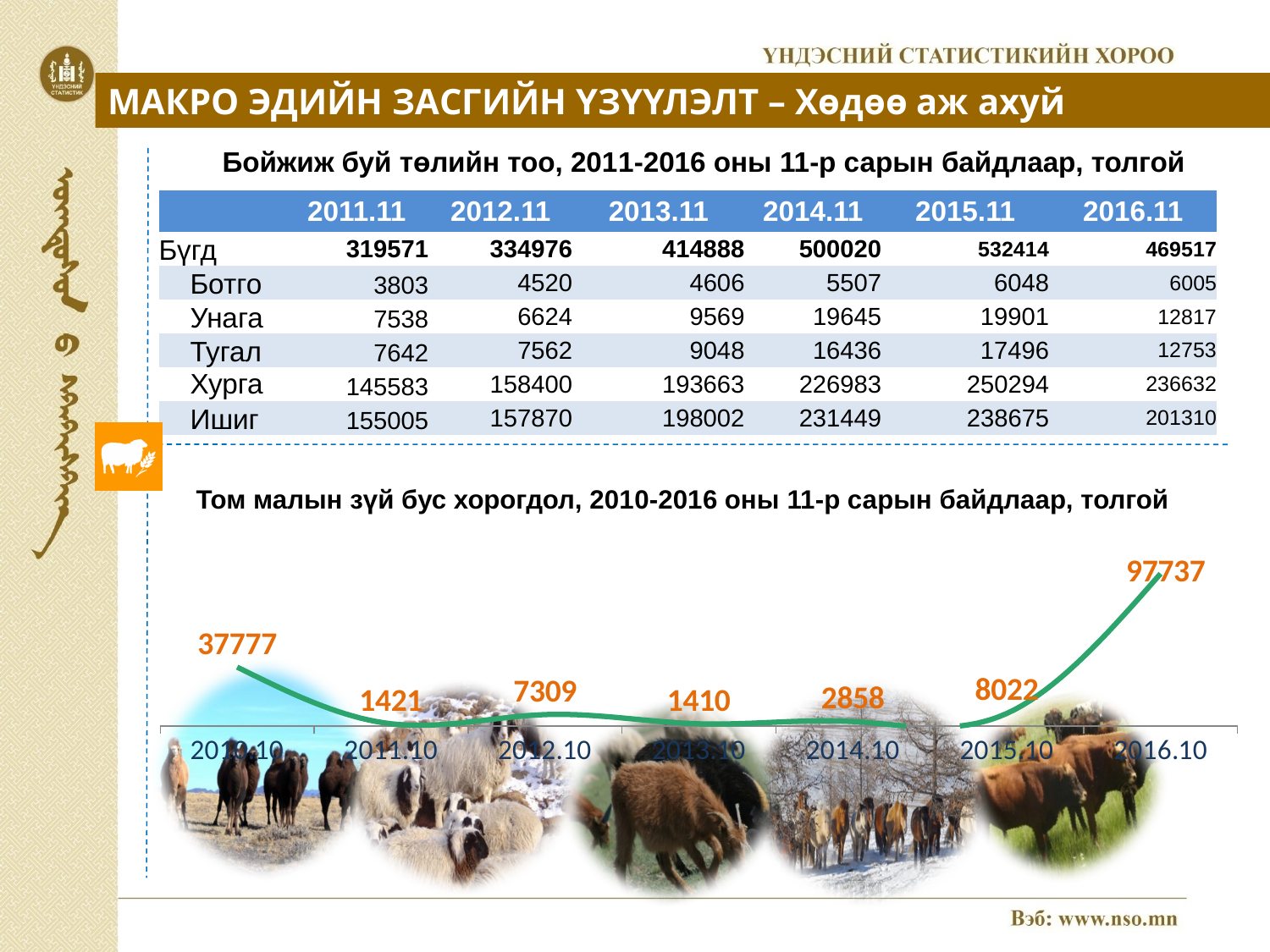
In the line chart 'Том малын зүй бус хорогдол', what is the value for 2015.10? 8022 In the line chart 'Том малын зүй бус хорогдол', what is the difference between the values for 2016.10 and 2015.10? 89715 In the line chart 'Том малын зүй бус хорогдол', what is the value for 2010.10? 37777 In the line chart 'Том малын зүй бус хорогдол', which year has the highest value? 2016.10 In the line chart 'Том малын зүй бус хорогдол', what is the value for 2012.10? 7309 In the line chart 'Том малын зүй бус хорогдол', what is the value for 2016.10? 97737 How many data points are plotted in the line chart 'Том малын зүй бус хорогдол'? 7 In the line chart 'Том малын зүй бус хорогдол', does the value rise or fall from 2010.10 to 2011.10? fall In the line chart 'Том малын зүй бус хорогдол', what is the difference between the values for 2014.10 and 2013.10? 1448 In the line chart 'Том малын зүй бус хорогдол', which is larger, the value for 2011.10 or the value for 2012.10? 2012.10 What type of chart is shown at the bottom of the slide under the title 'Том малын зүй бус хорогдол'? line chart In the line chart 'Том малын зүй бус хорогдол', which year has the lowest value? 2013.10